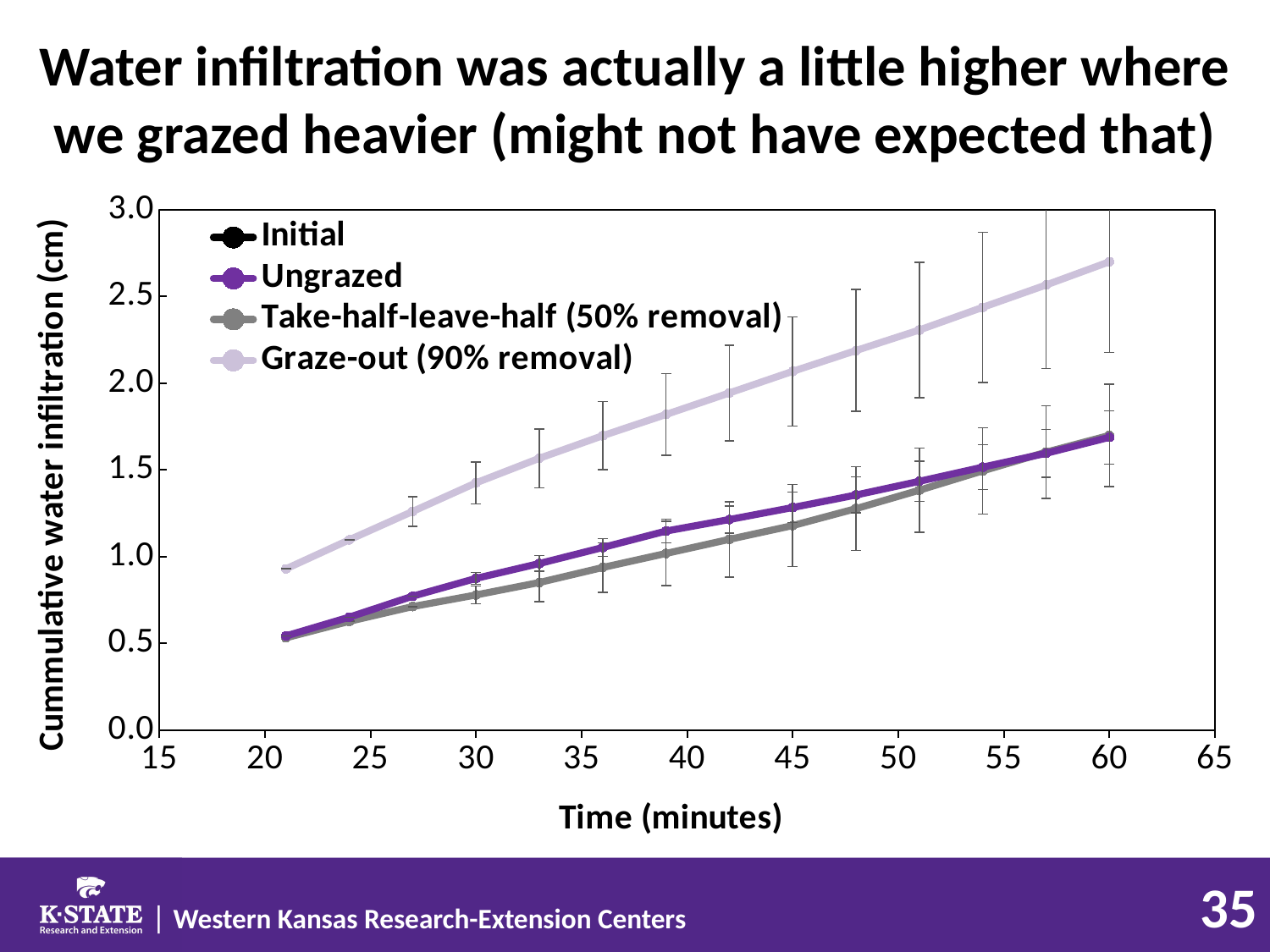
Is the value for Graze-out (90% removal) at 60 minutes greater or less than 2.5? greater Is the value for Ungrazed at 60 minutes greater or less than 2.0? less What is the label of the y axis? Cummulative water infiltration (cm) Do the values for Graze-out (90% removal) rise or fall as time increases? rise Is the value for Graze-out (90% removal) at 30 minutes greater or less than 1.0? greater What is the label of the x axis? Time (minutes) At 39 minutes, which is higher: Ungrazed or Take-half-leave-half (50% removal)? Ungrazed How many series does the legend list? 4 What kind of chart is shown on the slide? line chart Which series has the highest cumulative water infiltration at 60 minutes? Graze-out (90% removal)